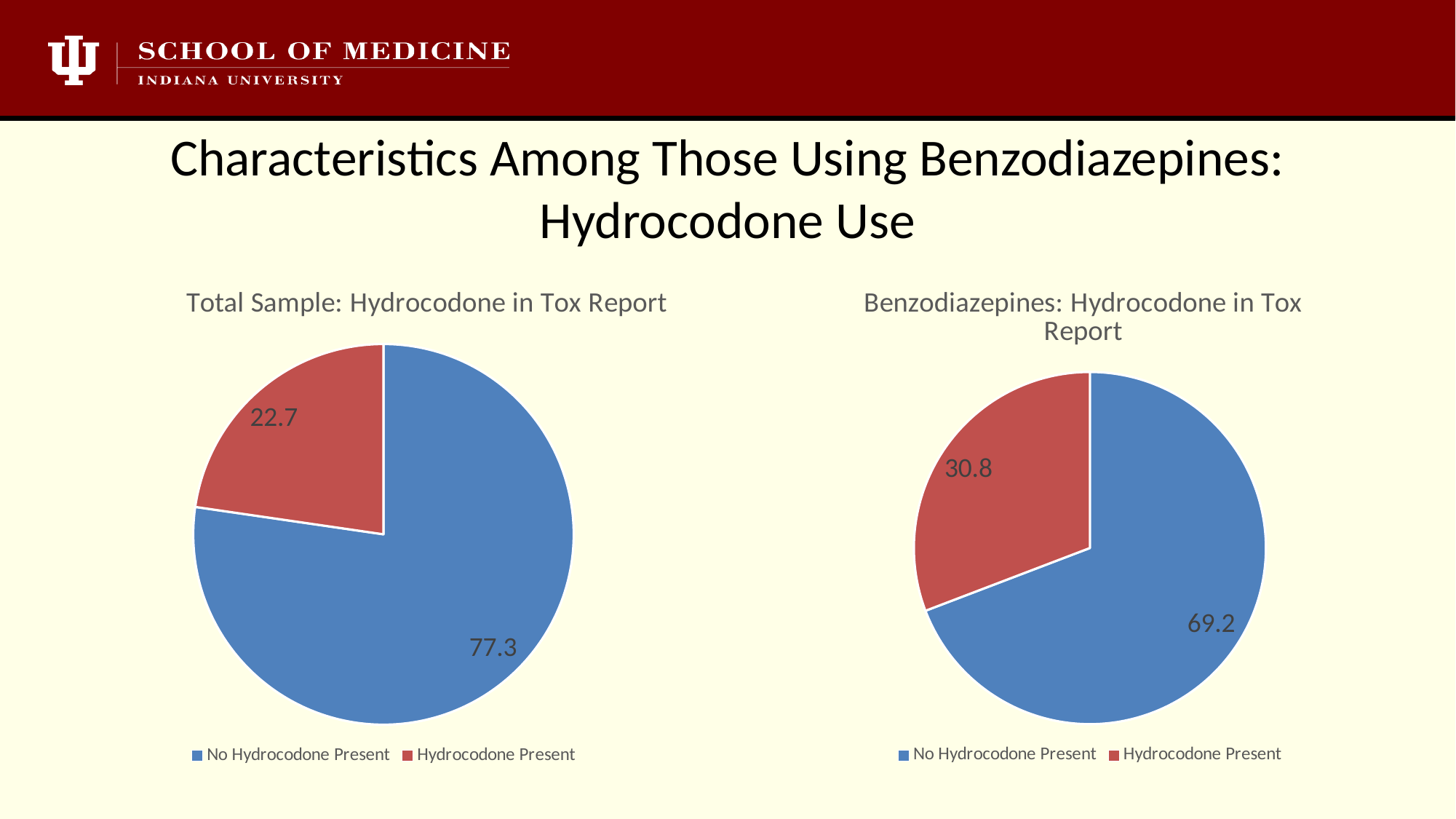
Which chart has the larger Hydrocodone Present value, the 'Total Sample' chart or the 'Benzodiazepines' chart? Benzodiazepines: Hydrocodone in Tox Report In the 'Benzodiazepines: Hydrocodone in Tox Report' chart, what is the value for No Hydrocodone Present? 69.2 In the 'Total Sample: Hydrocodone in Tox Report' chart, what is the difference between the No Hydrocodone Present and Hydrocodone Present values? 54.6 In the 'Total Sample: Hydrocodone in Tox Report' chart, what is the value for Hydrocodone Present? 22.7 What type of chart is the 'Total Sample: Hydrocodone in Tox Report' chart? Pie chart In the 'Total Sample: Hydrocodone in Tox Report' chart, what is the value for No Hydrocodone Present? 77.3 In the 'Total Sample: Hydrocodone in Tox Report' chart, which slice is the largest? No Hydrocodone Present In the 'Benzodiazepines: Hydrocodone in Tox Report' chart, what is the value for Hydrocodone Present? 30.8 In the 'Total Sample: Hydrocodone in Tox Report' chart, what colour is the Hydrocodone Present slice? Red In the 'Benzodiazepines: Hydrocodone in Tox Report' chart, which slice is the smallest? Hydrocodone Present In the 'Benzodiazepines: Hydrocodone in Tox Report' chart, what is the difference between the No Hydrocodone Present and Hydrocodone Present values? 38.4 How many slices does the 'Benzodiazepines: Hydrocodone in Tox Report' chart have? 2